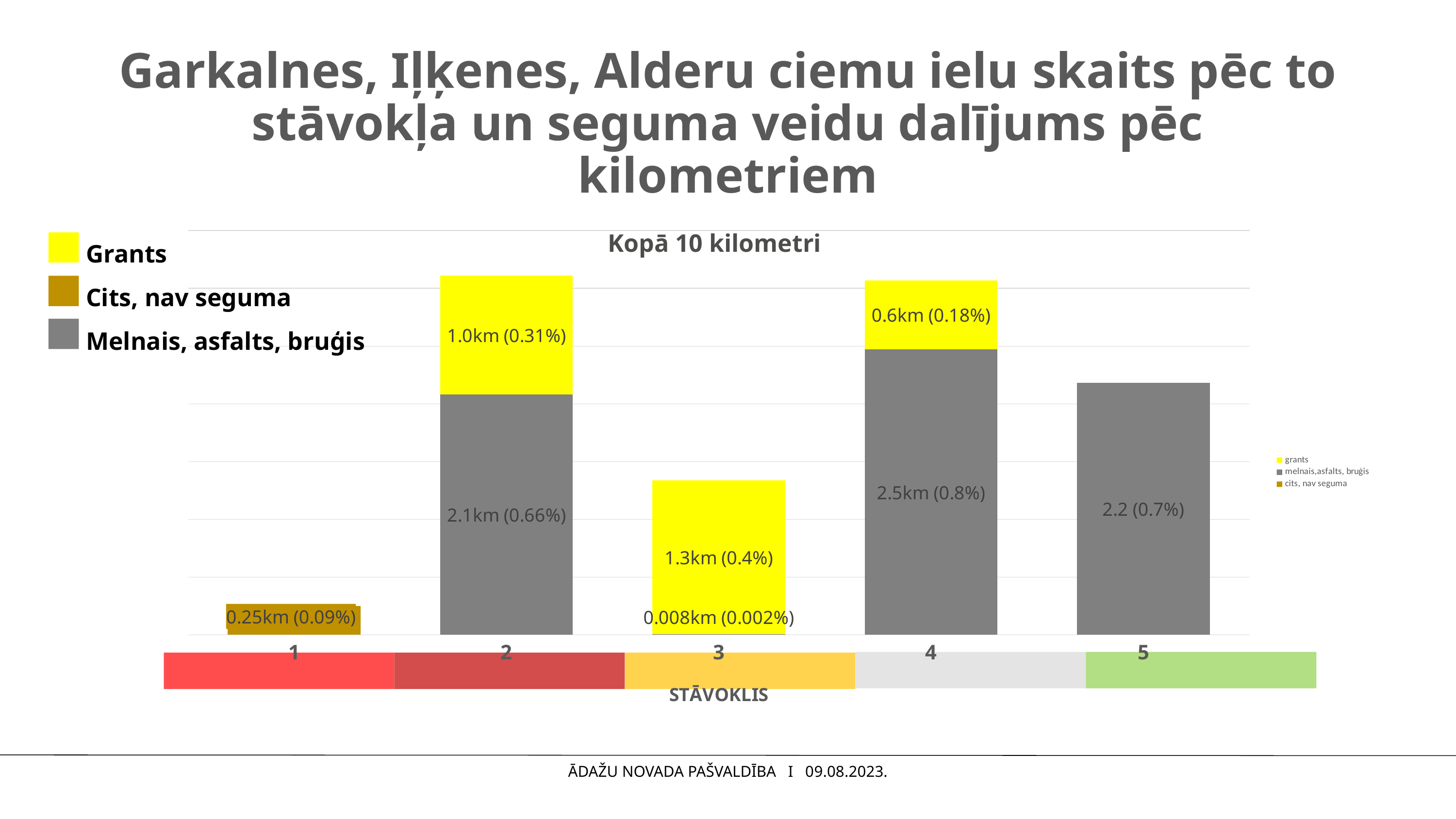
What is the difference in kilometres between the melnais, asfalts, bruģis segments of category 4 and category 2? 0.4km What is the value of the melnais, asfalts, bruģis segment for category 4? 2.5km (0.8%) What kind of chart is shown on the slide? Stacked bar chart What is the total of the stacked bar for category 2 in kilometres? 3.1km What is the value shown for category 5? 2.2 (0.7%) How many series does the legend list? 3 How many categories are shown on the x axis? 5 Which category has the lowest total stacked bar? 1 What is the value of the cits, nav seguma segment for category 1? 0.25km (0.09%) Is the grants segment larger for category 2 or category 4? Category 2 What is the value of the grants segment for category 3? 1.3km (0.4%) What is the value of the grants segment for category 2? 1.0km (0.31%)